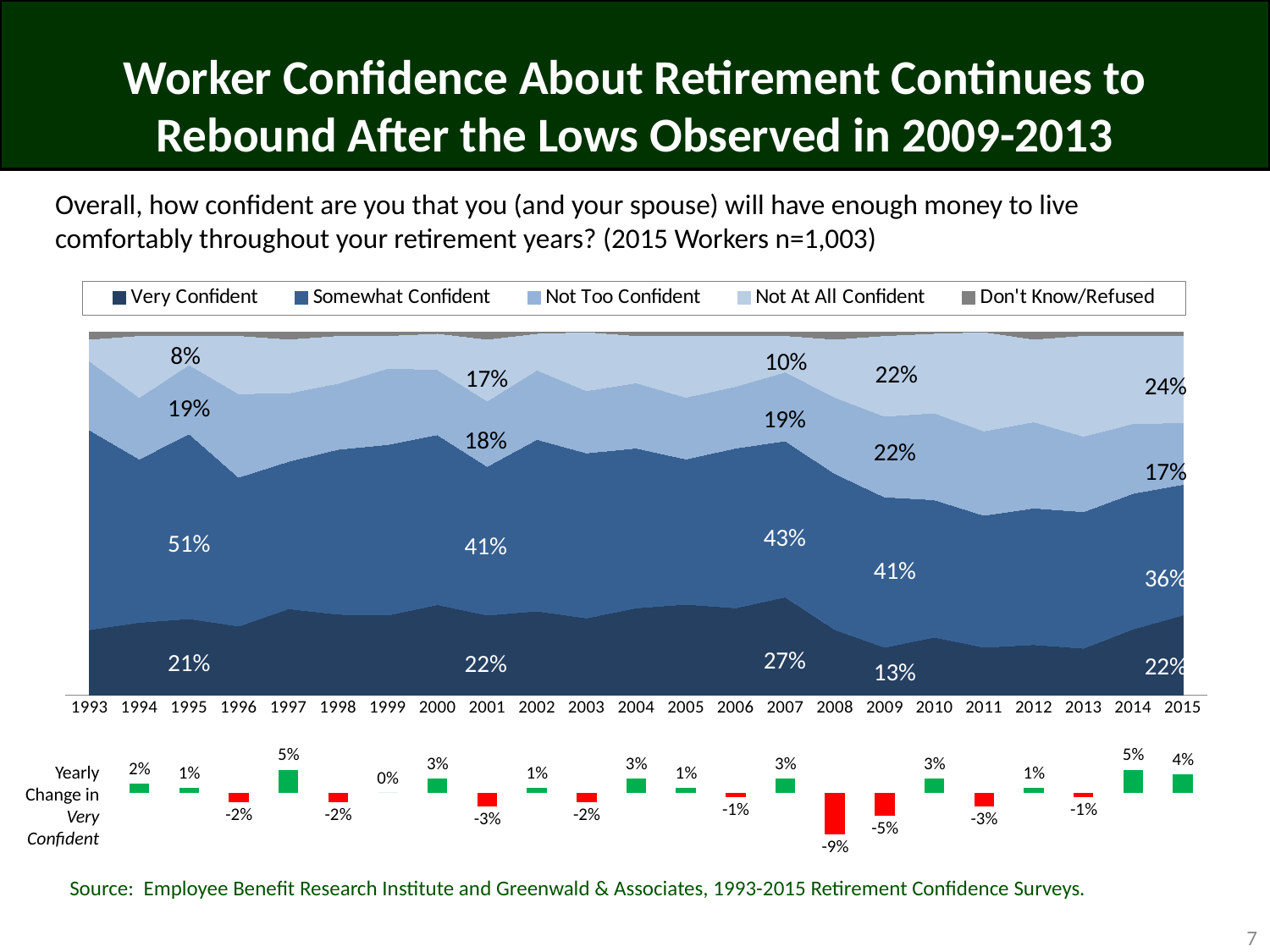
What kind of chart is the main chart showing confidence levels from 1993 to 2015? Stacked area chart In the Yearly Change in Very Confident bar chart, which year shows the lowest value? 2008 In the stacked area chart, what is the difference between the Very Confident percentage in 2007 and in 2009? 14 percentage points In the Yearly Change in Very Confident bar chart, what is the value for 2008? -9% In the stacked area chart, what percentage of workers were Very Confident in 2009? 13% In the stacked area chart, what percentage of workers were Somewhat Confident in 1995? 51% In the stacked area chart, what percentage of workers were Not At All Confident in 2015? 24% In the stacked area chart, which year has a higher Somewhat Confident percentage, 1995 or 2015? 1995 In the stacked area chart, what percentage of workers were Not Too Confident in 2001? 18% How many years are shown on the x axis of the stacked area chart? 23 How many series does the legend of the stacked area chart list? 5